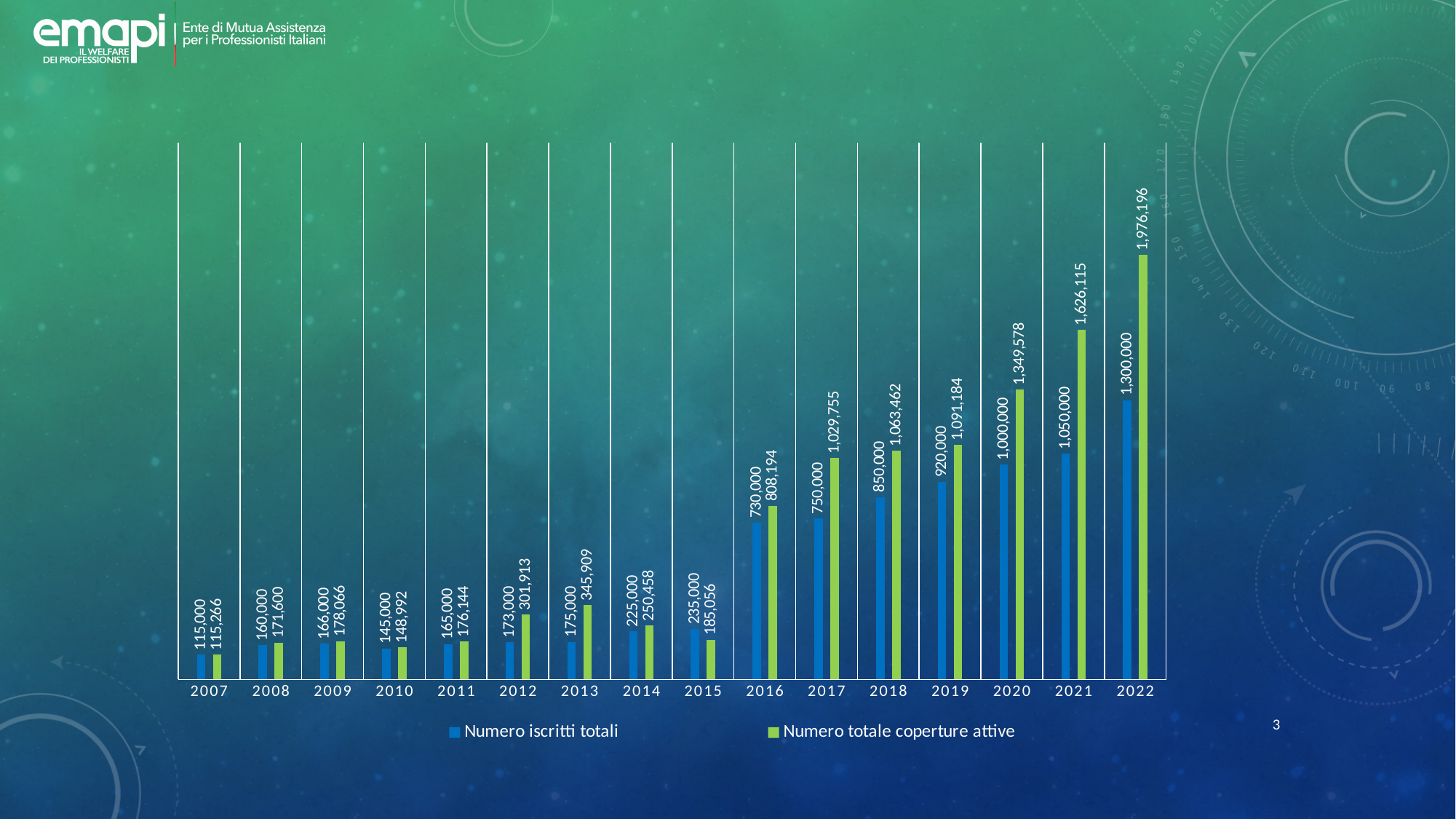
In 2015, which is larger: Numero iscritti totali or Numero totale coperture attive? Numero iscritti totali Which year has the lowest value for Numero iscritti totali? 2007 How many series does the legend list? 2 What is the difference between Numero totale coperture attive and Numero iscritti totali in 2022? 676,196 How many years are shown on the x axis? 16 What type of chart is shown on the slide? bar chart Which colour represents Numero totale coperture attive in the legend? green What is the value of Numero iscritti totali for 2016? 730,000 What is the value of Numero totale coperture attive for 2013? 345,909 What is the value of Numero totale coperture attive for 2020? 1,349,578 Which year has the highest value for Numero totale coperture attive? 2022 Do the values for Numero totale coperture attive generally rise or fall from 2016 to 2022? rise